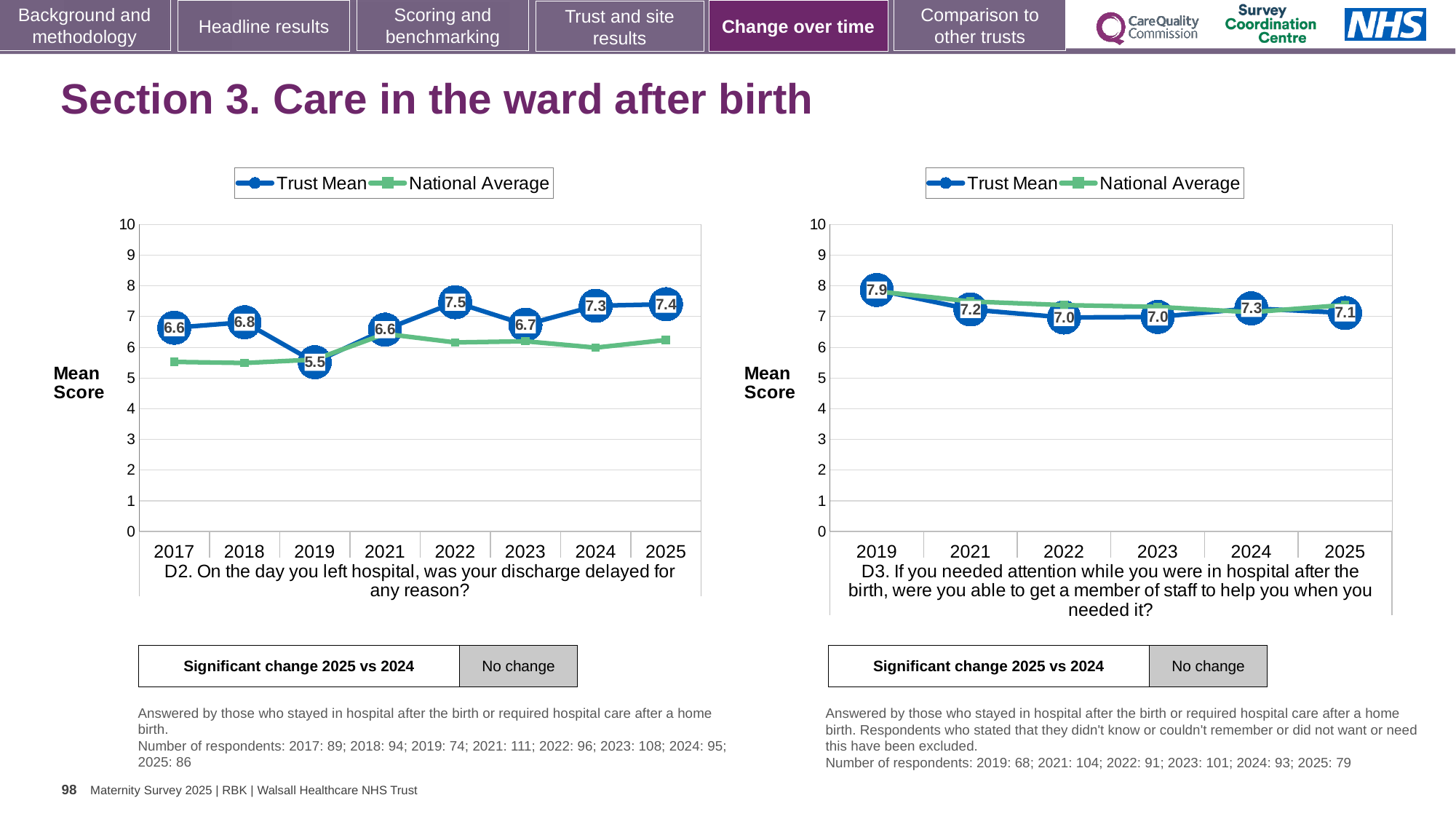
What kind of chart is the D3 chart (right)? Line chart In the D2 chart (left), what is the difference between the Trust Mean in 2022 and in 2019? 2.0 In the D2 chart (left), which year has the highest Trust Mean? 2022 In the D2 chart (left), what is the Trust Mean for 2025? 7.4 In the D3 chart (right), what is the Trust Mean for 2019? 7.9 In the D2 chart (left), which year has the lowest Trust Mean? 2019 In the D3 chart (right), is the Trust Mean larger in 2024 or in 2025? 2024 In the D2 chart (left), is the National Average for 2017 greater or less than 6? less In the D2 chart (left), how many years are shown on the x axis? 8 In the D3 chart (right), which year has the highest Trust Mean? 2019 In the D3 chart (right), how many series does the legend list? 2 In the D2 chart (left), what is the Trust Mean for 2019? 5.5